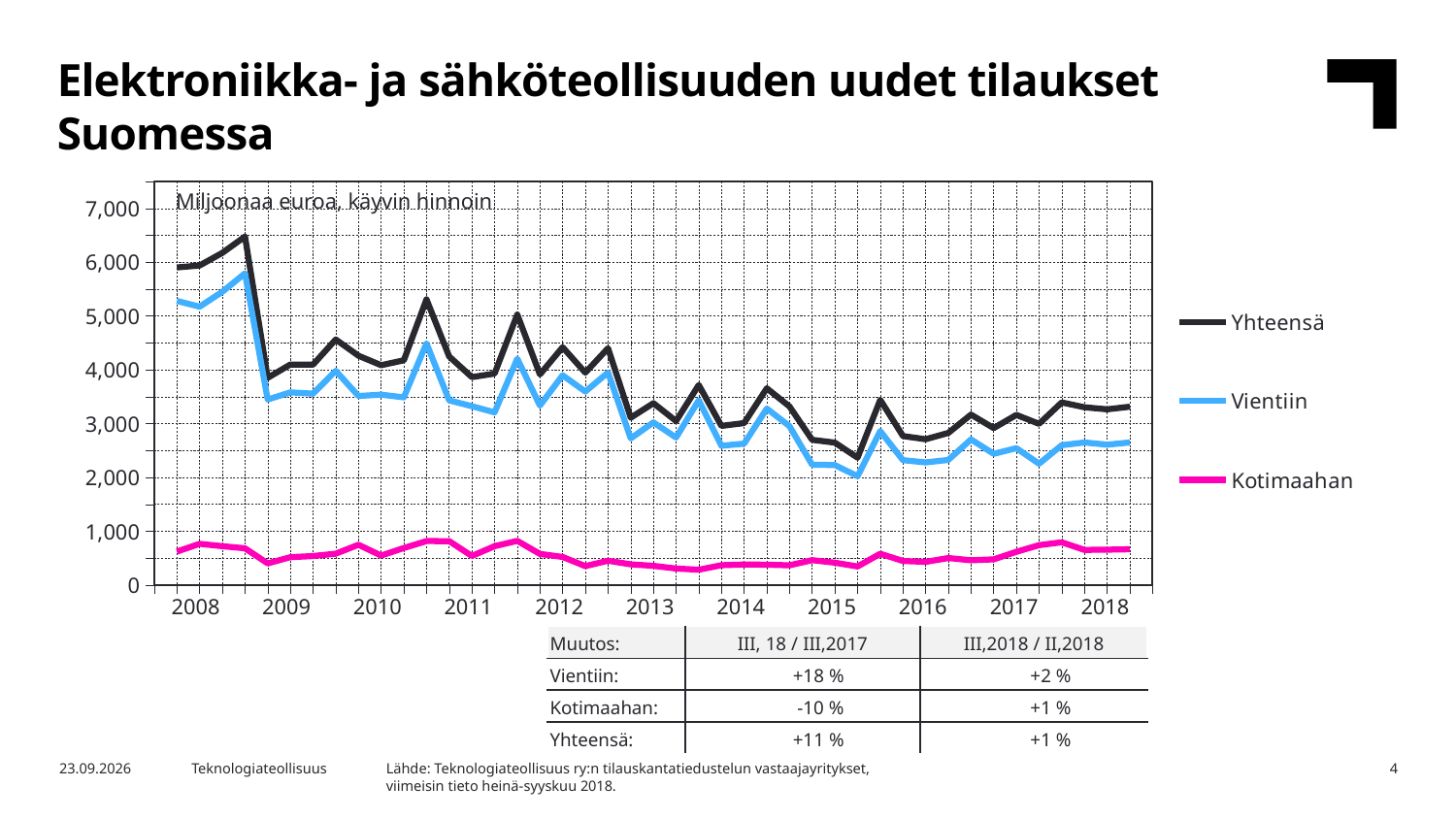
Is the peak value of Yhteensä in 2008 greater or less than 6,000? greater Is the value for Kotimaahan in 2018 greater or less than 1,000? less How many series does the legend list? 3 Is the value for Vientiin at the end of 2018 greater or less than 2,000? greater Which is larger in 2018, Vientiin or Kotimaahan? Vientiin Does the Yhteensä series overall rise or fall from 2008 to 2018? Fall How many years are labelled on the x axis? 11 What unit is stated at the top of the chart area? Miljoonaa euroa, käyvin hinnoin Which series has the lowest values throughout the chart? Kotimaahan Which series has the highest values throughout the chart? Yhteensä What kind of chart is shown on the slide? Line chart Which series are listed in the chart legend? Yhteensä, Vientiin, Kotimaahan